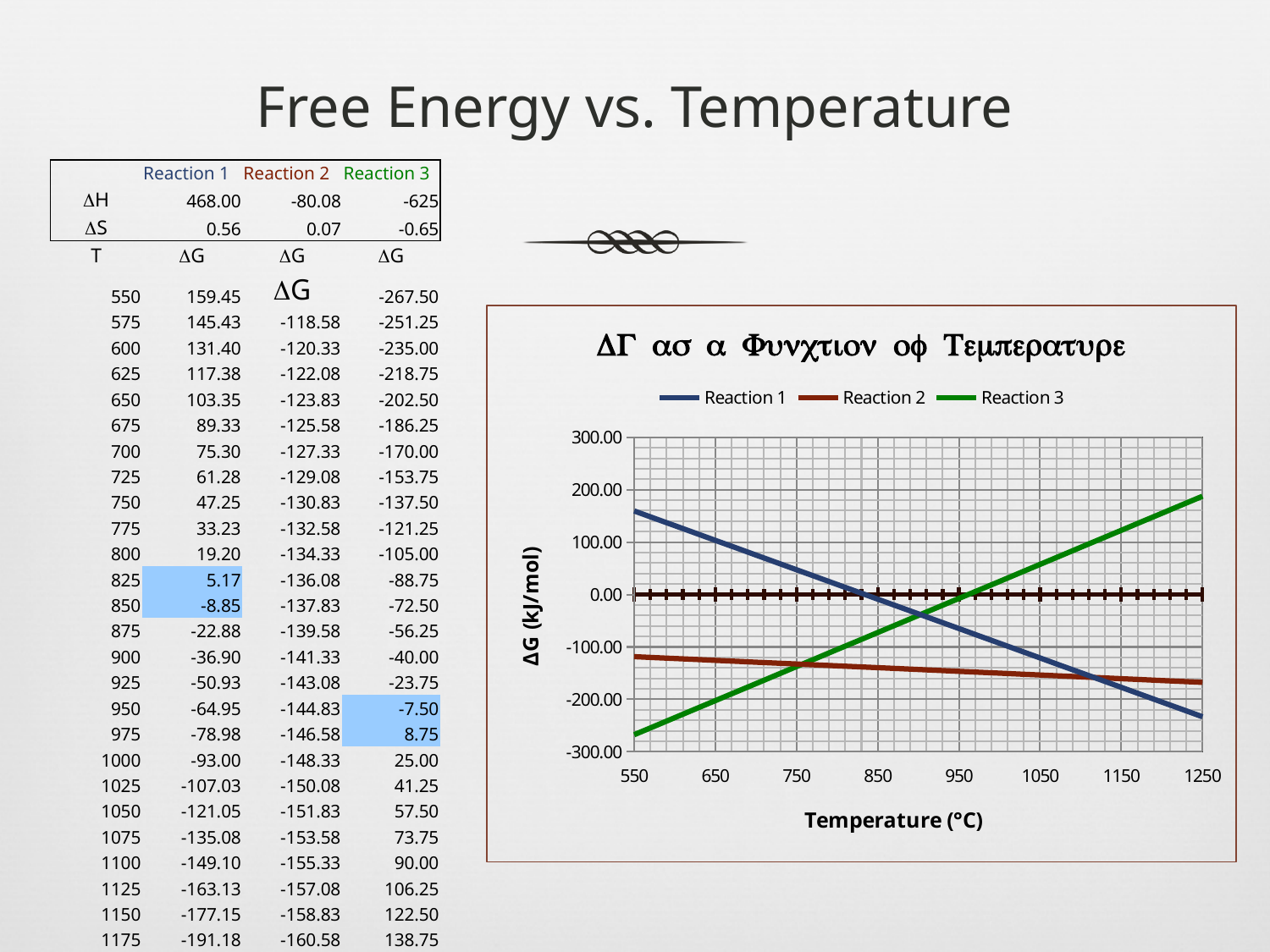
What is the label of the chart's y axis? ΔG (kJ/mol) How many series does the chart legend list? 3 What is the label of the chart's x axis? Temperature (°C) Is the value for Reaction 3 at 550 °C greater or less than -200.00? less Is the value for Reaction 1 at 550 °C greater or less than 100.00? greater At 1250 °C, which series has the higher ΔG value, Reaction 1 or Reaction 3? Reaction 3 Is the value for Reaction 3 at 1250 °C greater or less than 100.00? greater What kind of chart is shown on the slide? line chart Does the Reaction 3 line rise or fall as temperature increases? rise At 550 °C, which series has the higher ΔG value, Reaction 1 or Reaction 3? Reaction 1 Does the Reaction 1 line rise or fall as temperature increases? fall